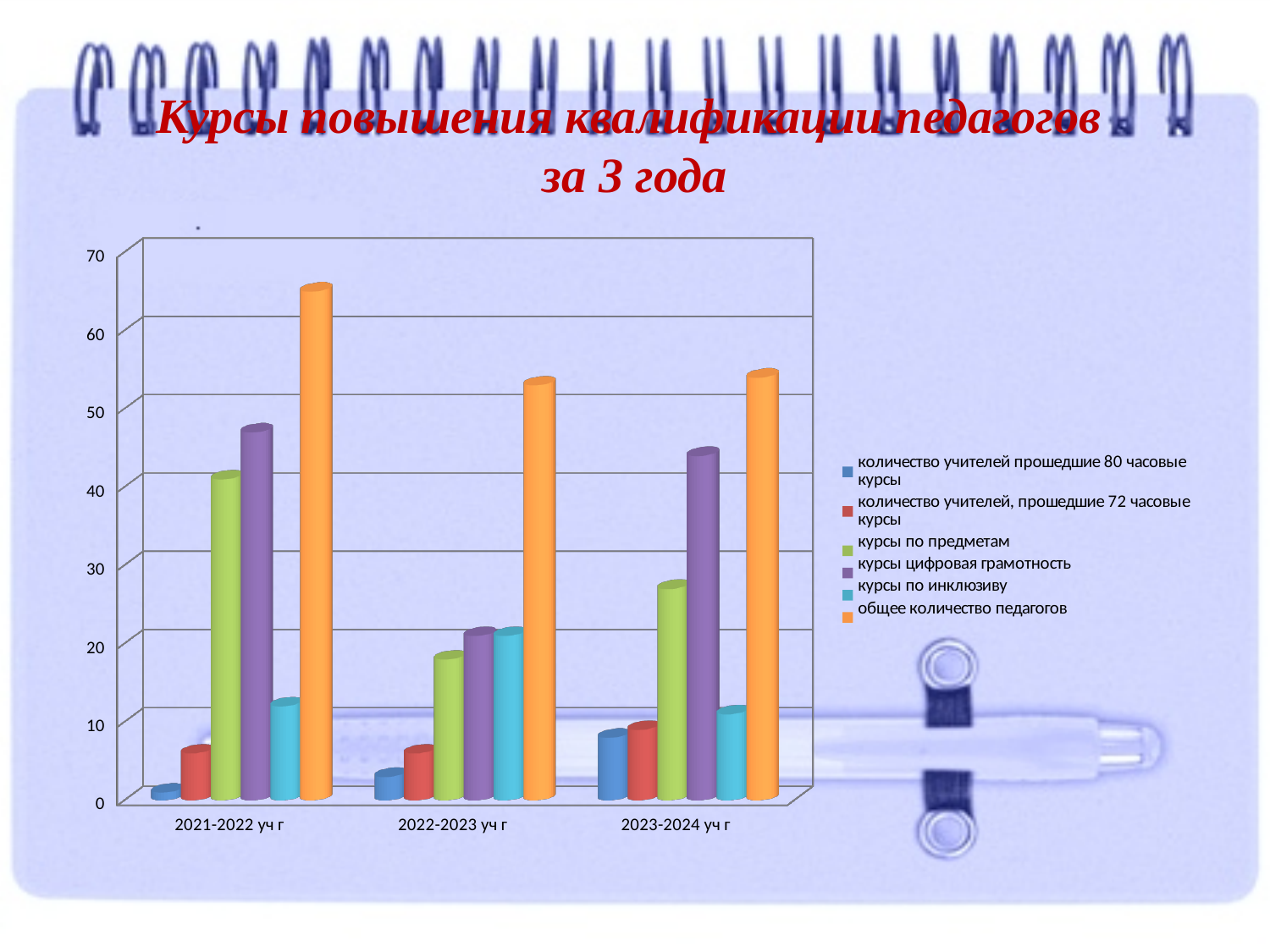
Does the value for 'количество учителей прошедшие 80 часовые курсы' rise or fall from 2021-2022 уч г to 2023-2024 уч г? rise What kind of chart is shown on the slide? bar chart In which academic year is the value for 'общее количество педагогов' the highest? 2021-2022 уч г Is the value for 'курсы цифровая грамотность' in 2023-2024 уч г greater or less than 40? greater In which academic year is the value for 'курсы по предметам' the lowest? 2022-2023 уч г What is the title of the chart on the slide? Курсы повышения квалификации педагогов за 3 года In 2021-2022 уч г, which is larger: 'курсы по предметам' or 'курсы цифровая грамотность'? курсы цифровая грамотность Is the value for 'курсы по предметам' in 2021-2022 уч г greater or less than 30? greater How many academic years (categories) are shown on the x axis? 3 How many series does the legend list? 6 Is the value for 'общее количество педагогов' in 2021-2022 уч г greater or less than 60? greater